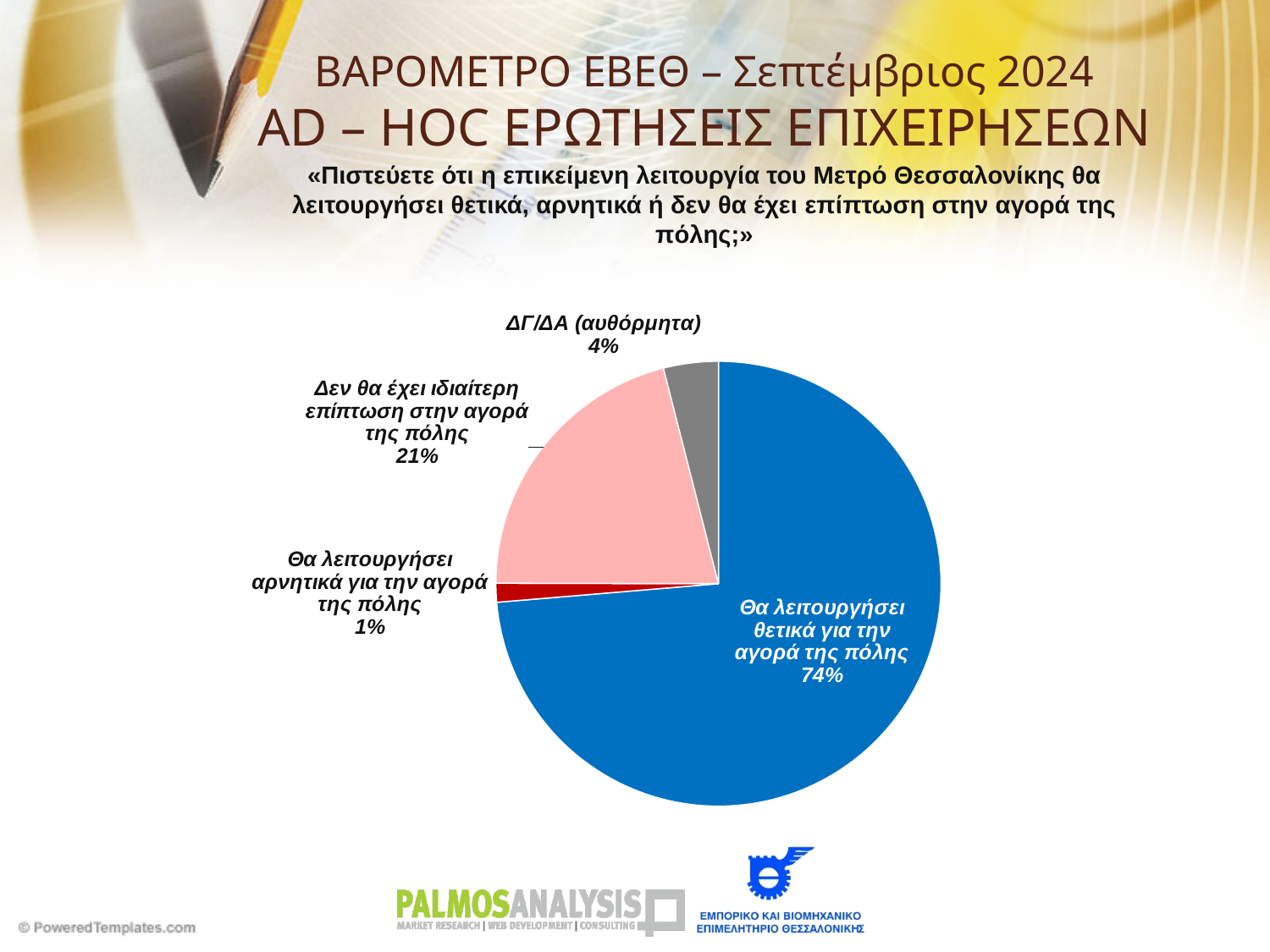
What percentage of respondents answered «Θα λειτουργήσει θετικά για την αγορά της πόλης»? 74% What percentage of respondents answered «Δεν θα έχει ιδιαίτερη επίπτωση στην αγορά της πόλης»? 21% Which response has the largest share of the pie? Θα λειτουργήσει θετικά για την αγορά της πόλης Which response has the smallest share of the pie? Θα λειτουργήσει αρνητικά για την αγορά της πόλης What colour is the slice for «Θα λειτουργήσει θετικά για την αγορά της πόλης»? blue Which is larger: the share for «ΔΓ/ΔΑ (αυθόρμητα)» or the share for «Θα λειτουργήσει αρνητικά για την αγορά της πόλης»? ΔΓ/ΔΑ (αυθόρμητα) What percentage of respondents answered «Θα λειτουργήσει αρνητικά για την αγορά της πόλης»? 1% What is the difference in percentage points between «Θα λειτουργήσει θετικά» (74%) and «Δεν θα έχει ιδιαίτερη επίπτωση» (21%)? 53 percentage points What kind of chart is shown on the slide? pie chart How many slices does the pie chart have? 4 What percentage is shown for «ΔΓ/ΔΑ (αυθόρμητα)»? 4% What colour is the slice for «ΔΓ/ΔΑ (αυθόρμητα)»? grey